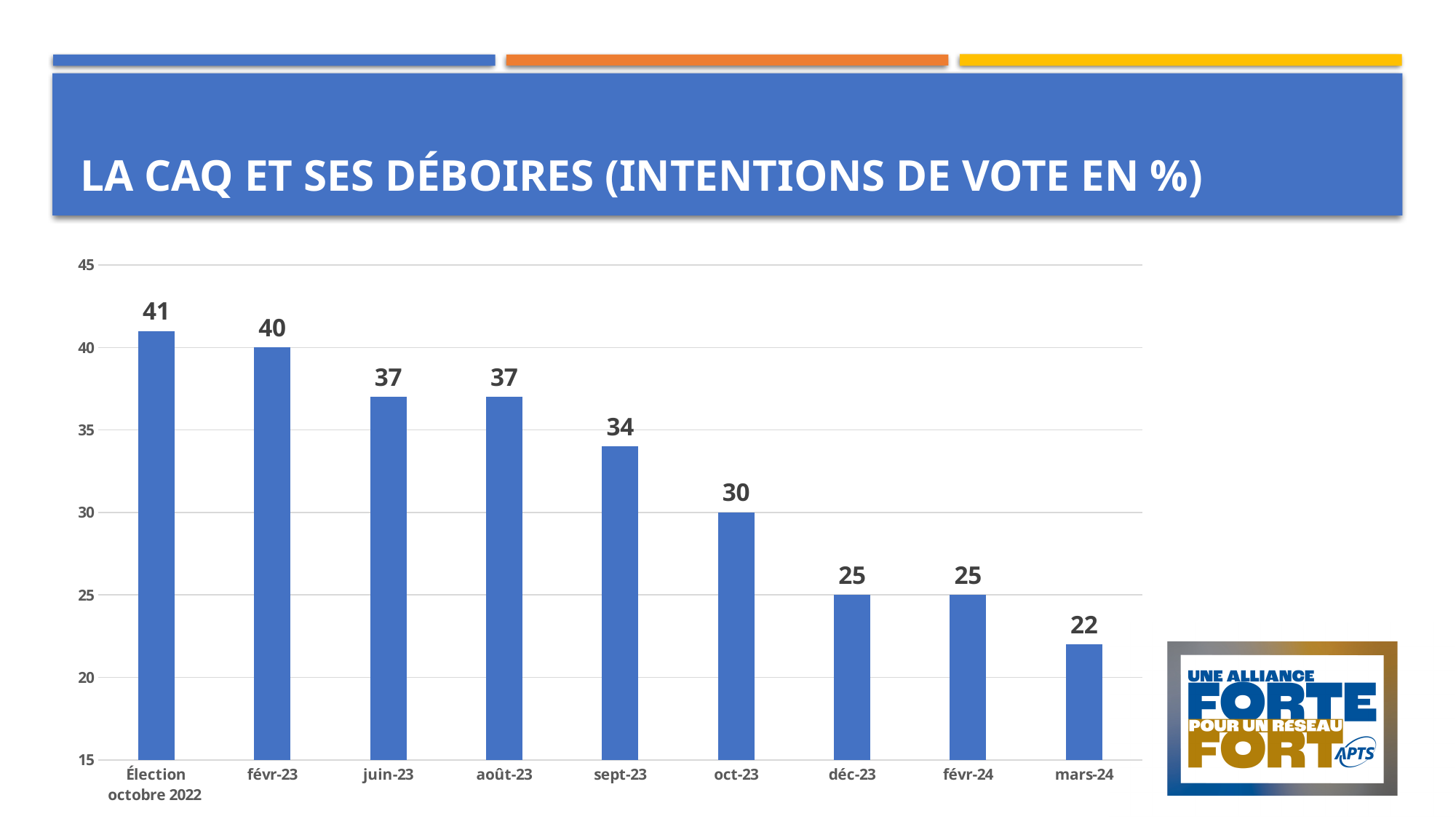
What is the title of the chart? LA CAQ ET SES DÉBOIRES (INTENTIONS DE VOTE EN %) How many categories are shown on the x axis? 9 What is the value for sept-23? 34 What is the value for mars-24? 22 What is the difference between the value for oct-23 and the value for déc-23? 5 Which category has the highest value? Élection octobre 2022 Which category has the lowest value? mars-24 What is the difference between the value for Élection octobre 2022 and the value for mars-24? 19 Do the values generally rise or fall from left to right along the x axis? fall What is the value for Élection octobre 2022? 41 What kind of chart is this? bar chart Which is larger, the value for juin-23 or the value for oct-23? juin-23